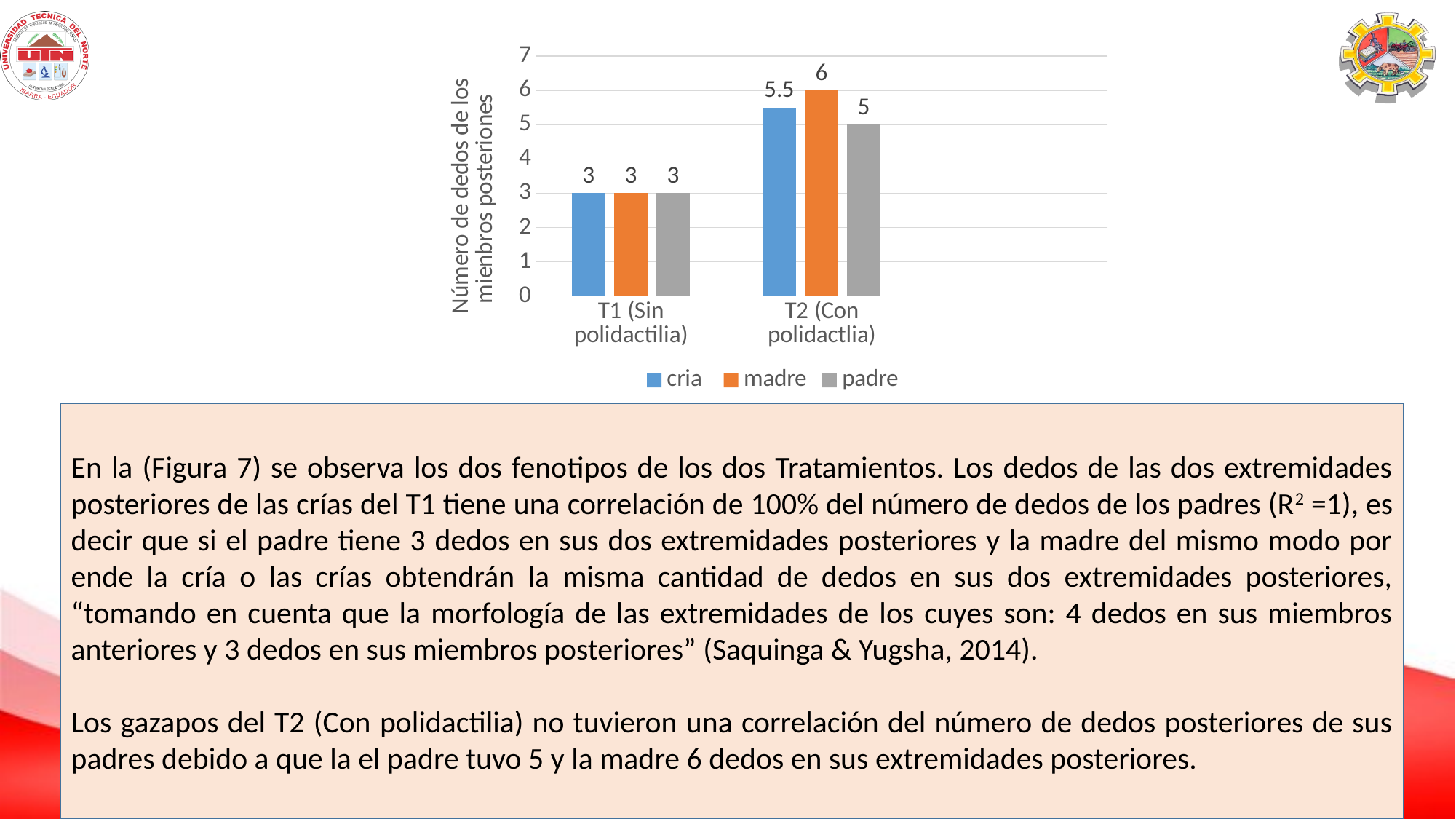
How many categories are shown on the x axis? 2 What is the label of the vertical axis? Número de dedos de los mienbros posteriores What is the value for cria in the T2 (Con polidactlia) category? 5.5 What is the difference between the madre value and the padre value in the T2 (Con polidactlia) category? 1 What is the difference between the cria value in T2 (Con polidactlia) and the cria value in T1 (Sin polidactilia)? 2.5 Which is larger, the cria value in T2 (Con polidactlia) or the padre value in T2 (Con polidactlia)? cria in T2 (Con polidactlia) Which series has the highest value in the T2 (Con polidactlia) category? madre Which series has the lowest value in the T2 (Con polidactlia) category? padre What kind of chart is shown on the slide? bar chart What is the value for padre in the T1 (Sin polidactilia) category? 3 How many series does the legend list? 3 What is the value for madre in the T2 (Con polidactlia) category? 6